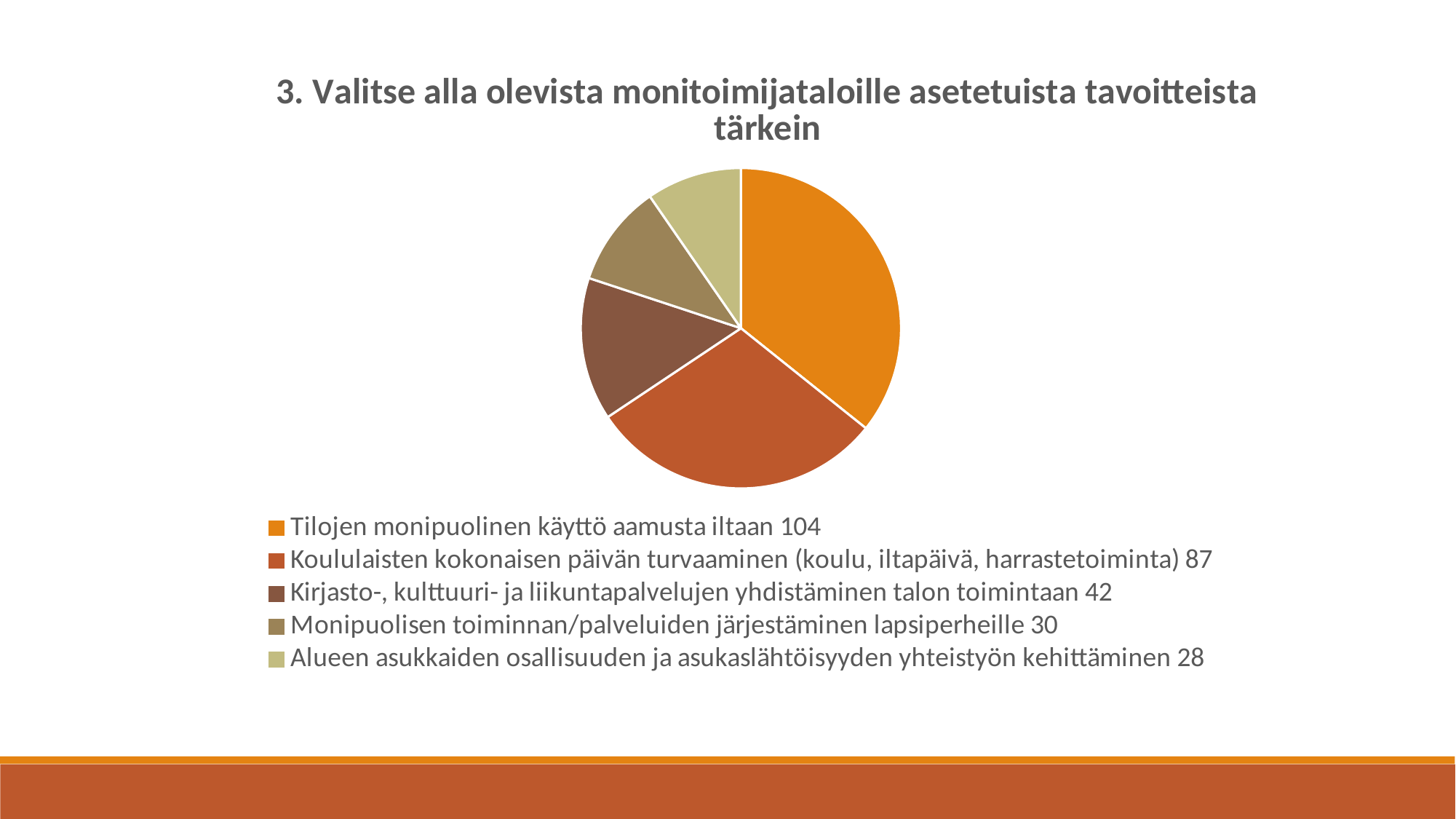
What is the value for "Kirjasto-, kulttuuri- ja liikuntapalvelujen yhdistäminen talon toimintaan"? 42 What is the value for "Koululaisten kokonaisen päivän turvaaminen (koulu, iltapäivä, harrastetoiminta)"? 87 Which is larger: the value for "Kirjasto-, kulttuuri- ja liikuntapalvelujen yhdistäminen talon toimintaan" or for "Monipuolisen toiminnan/palveluiden järjestäminen lapsiperheille"? Kirjasto-, kulttuuri- ja liikuntapalvelujen yhdistäminen talon toimintaan What is the title of the chart? 3. Valitse alla olevista monitoimijataloille asetetuista tavoitteista tärkein Which category has the smallest slice of the pie? Alueen asukkaiden osallisuuden ja asukaslähtöisyyden yhteistyön kehittäminen What kind of chart is shown on the slide? pie chart What is the value for "Tilojen monipuolinen käyttö aamusta iltaan"? 104 Which category has the largest slice of the pie? Tilojen monipuolinen käyttö aamusta iltaan What is the value for "Alueen asukkaiden osallisuuden ja asukaslähtöisyyden yhteistyön kehittäminen"? 28 What is the difference between the values for "Tilojen monipuolinen käyttö aamusta iltaan" and "Koululaisten kokonaisen päivän turvaaminen (koulu, iltapäivä, harrastetoiminta)"? 17 What is the total of all the values shown in the legend? 291 How many slices does the pie chart have? 5